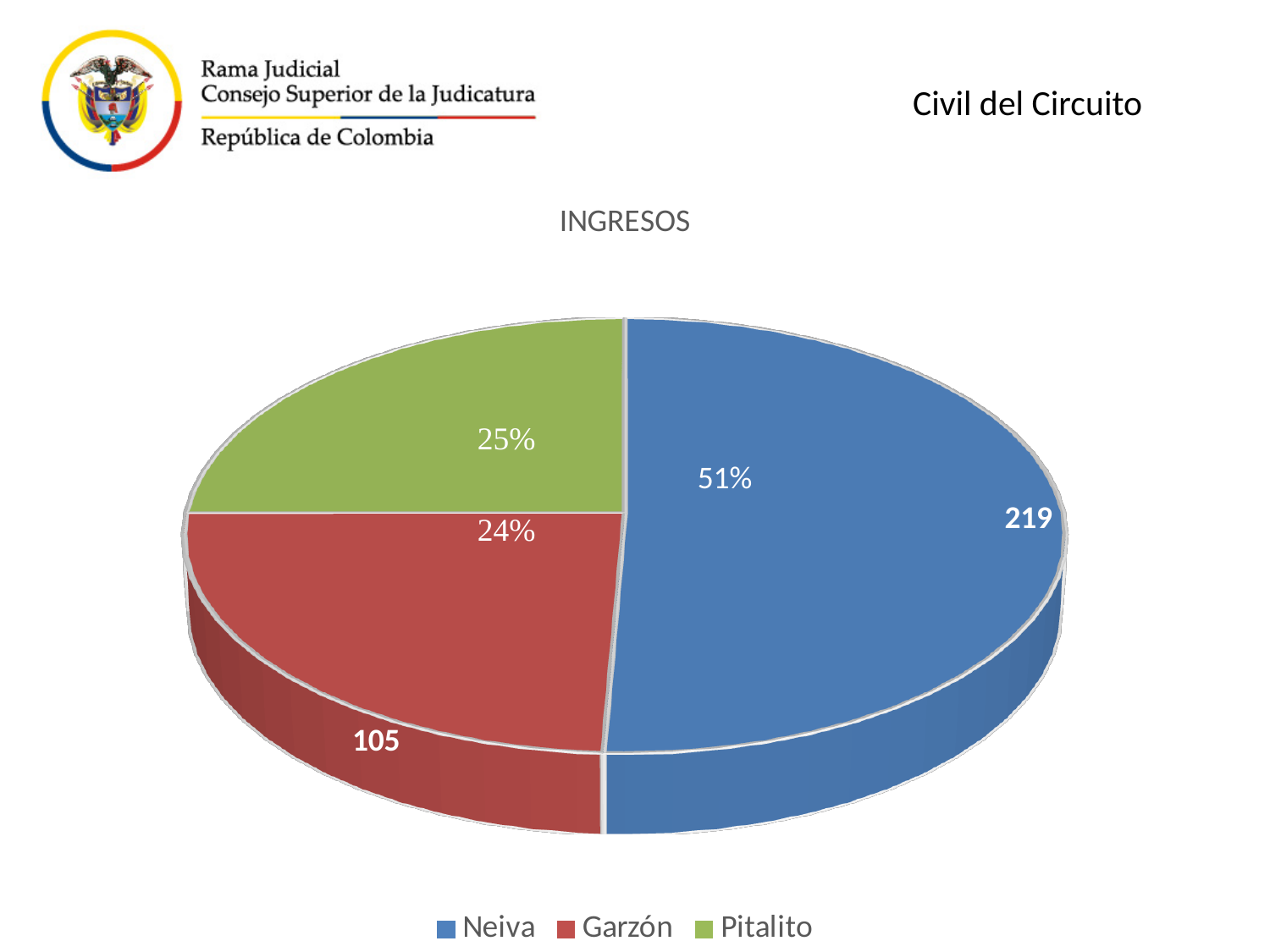
What share of the pie does Pitalito represent? 25% How many slices does the pie chart have? 3 How many entries does the legend list? 3 What share of the pie does Garzón represent? 24% What is the difference between the values for Neiva and Garzón? 114 What share of the pie does Neiva represent? 51% What value is shown for Garzón? 105 What value is shown for Neiva? 219 Which is larger, the value for Neiva or the value for Garzón? Neiva What type of chart is shown on the slide? Pie chart What is the title of the chart? INGRESOS Which category has the largest slice? Neiva